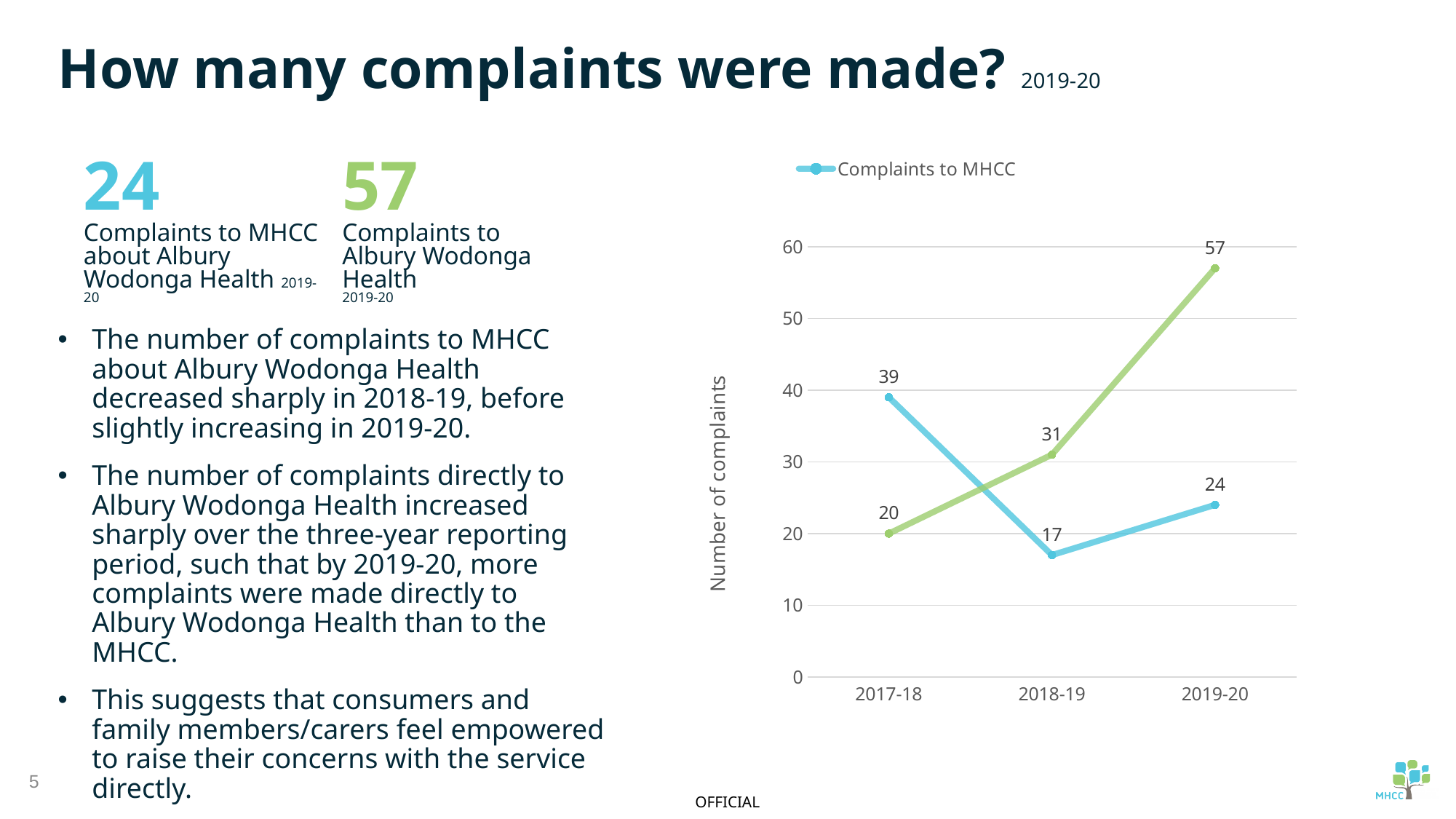
What is the difference between the green line and the Complaints to MHCC line in 2019-20? 33 In which year is the green line at its highest? 2019-20 In 2017-18, which is larger: the Complaints to MHCC value or the green line value? Complaints to MHCC Does the green line rise or fall from 2017-18 to 2019-20? rise What is the value of the green line in 2019-20? 57 What is the value for Complaints to MHCC in 2019-20? 24 What is the value of the green line in 2017-18? 20 What is the value for Complaints to MHCC in 2017-18? 39 What kind of chart is shown on the slide? line chart In which year is the Complaints to MHCC line at its lowest? 2018-19 What is the value for Complaints to MHCC in 2018-19? 17 How many years are shown on the x axis? 3